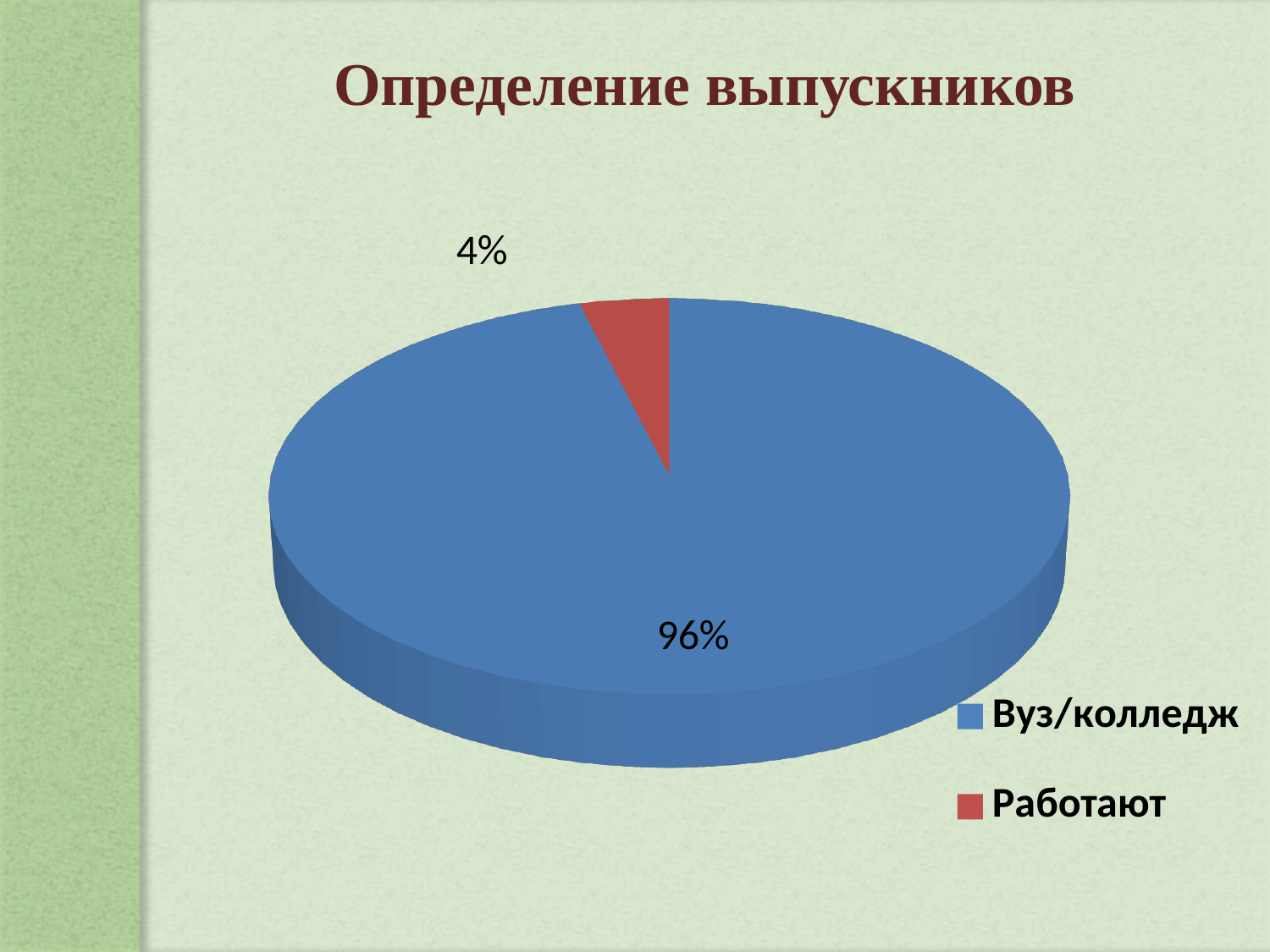
What is the title of the slide? Определение выпускников Which category has the smallest slice of the pie? Работают Which is larger, the Вуз/колледж slice or the Работают slice? Вуз/колледж What kind of chart is shown on the slide? pie chart Which category has the largest slice of the pie? Вуз/колледж How many slices does the pie chart have? 2 What share of the pie does Работают have? 4% How many entries does the legend list? 2 What colour is the Работают slice? red What share of the pie does Вуз/колледж have? 96% What is the difference in percentage points between the Вуз/колледж and Работают slices? 92